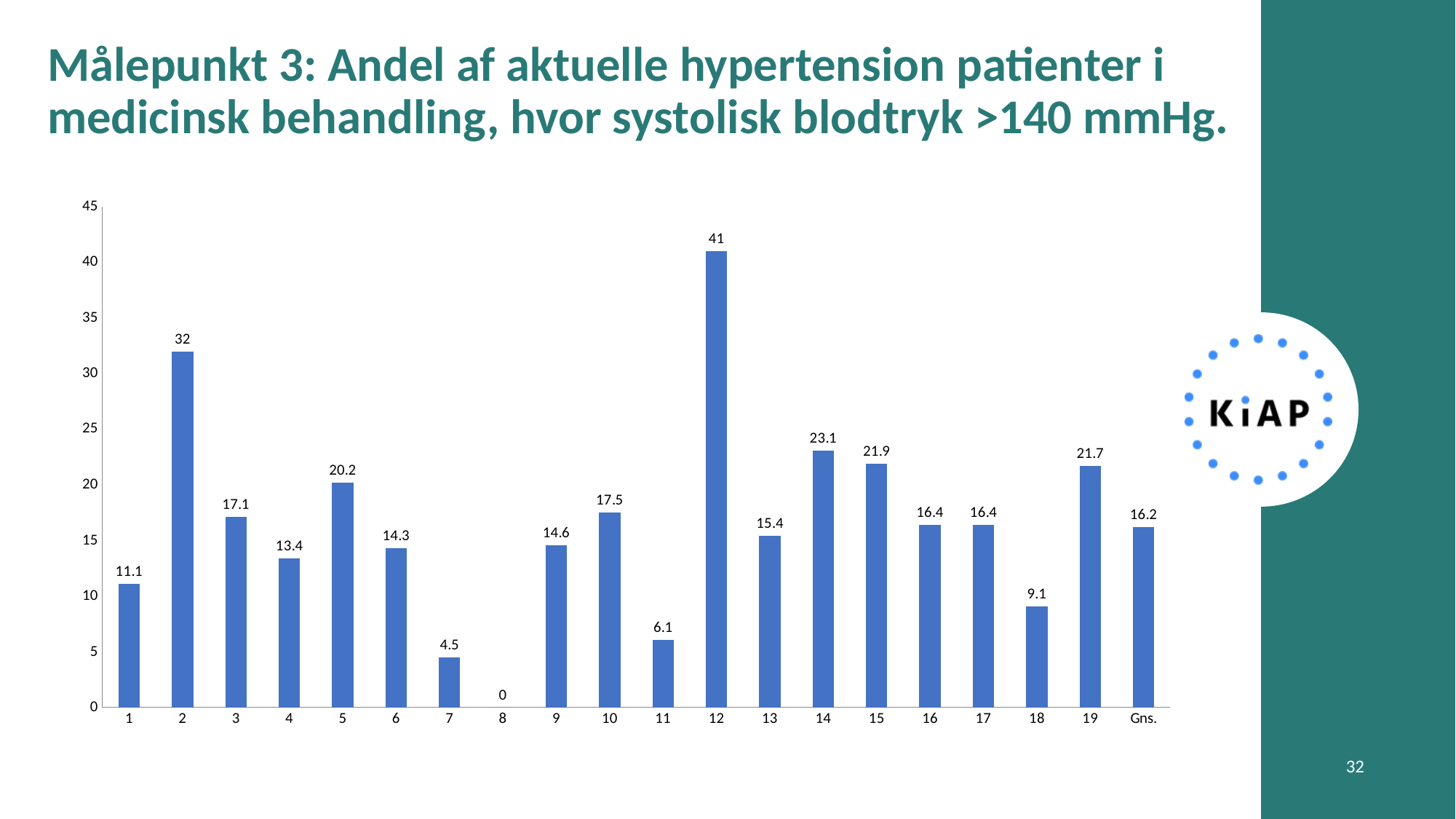
What is the highest value shown on the y axis? 45 Which category has the lowest value? 8 How many categories are shown on the x axis? 20 What is the value for category 12? 41 What is the difference between the values for category 18 and category 19? 12.6 What is the difference between the values for category 2 and category 12? 9 Which is larger, the value for category 14 or category 15? 14 What kind of chart is this? bar chart What is the value for Gns.? 16.2 Which category has the highest value? 12 Is the value for category 5 greater or less than 20? greater What is the value for category 7? 4.5